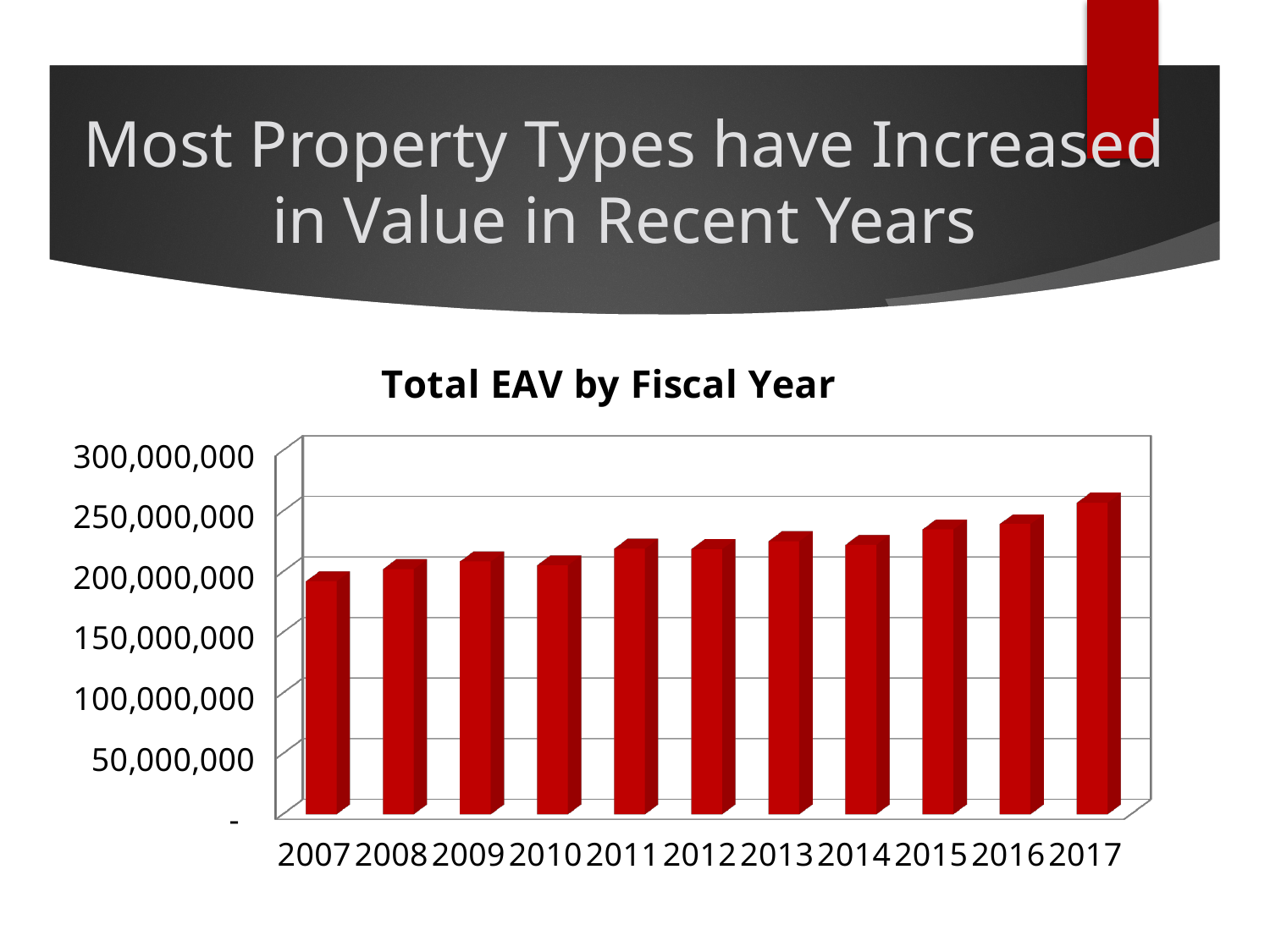
Which fiscal year has the highest Total EAV? 2017 How many fiscal years are shown on the x axis of the chart? 11 Is the Total EAV for 2013 greater or less than 150,000,000? greater What type of chart is shown on the slide? Bar chart Is the Total EAV for 2017 greater or less than 200,000,000? greater Is the Total EAV for 2007 greater or less than 200,000,000? less Overall, does Total EAV rise or fall from 2007 to 2017? Rise Which has a larger Total EAV, 2008 or 2015? 2015 Which has a larger Total EAV, 2007 or 2017? 2017 What is the title of the chart? Total EAV by Fiscal Year Which fiscal year has the lowest Total EAV? 2007